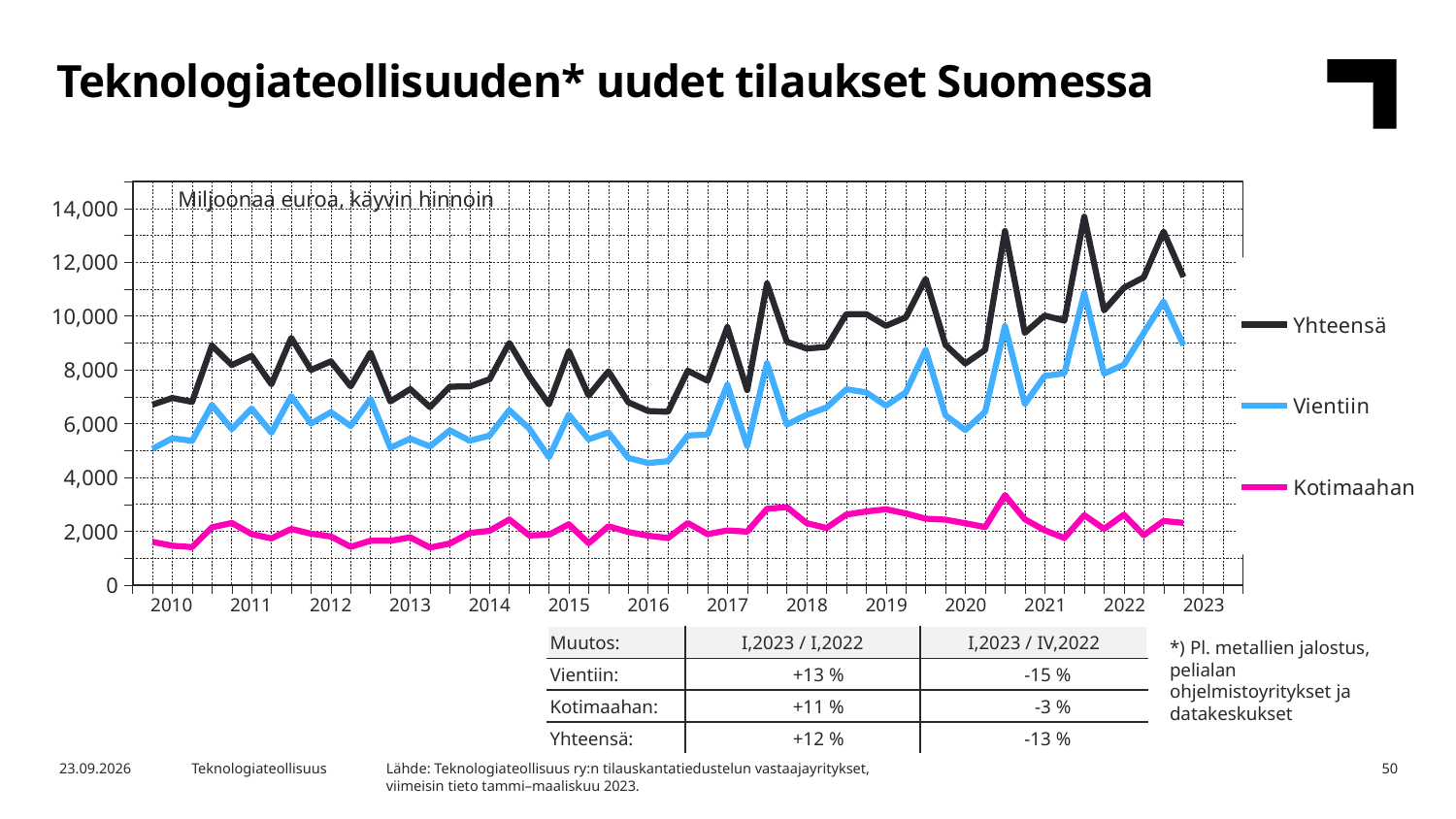
What kind of chart is shown on the slide? line chart Does the Yhteensä series overall rise or fall from 2010 to 2023? rise Is the value for Vientiin at the start of 2010 greater or less than 6,000? less What are the three series named in the legend? Yhteensä, Vientiin, Kotimaahan How many series does the legend list? 3 How many year labels are shown on the x axis? 14 What unit label is printed inside the chart area? Miljoonaa euroa, käyvin hinnoin Which series has the highest values throughout the chart? Yhteensä Which series is larger in 2019, Vientiin or Kotimaahan? Vientiin Is the value for Kotimaahan in 2010 greater or less than 4,000? less Is the peak value for Yhteensä in 2021 greater or less than 12,000? greater Which series has the lowest values throughout the chart? Kotimaahan